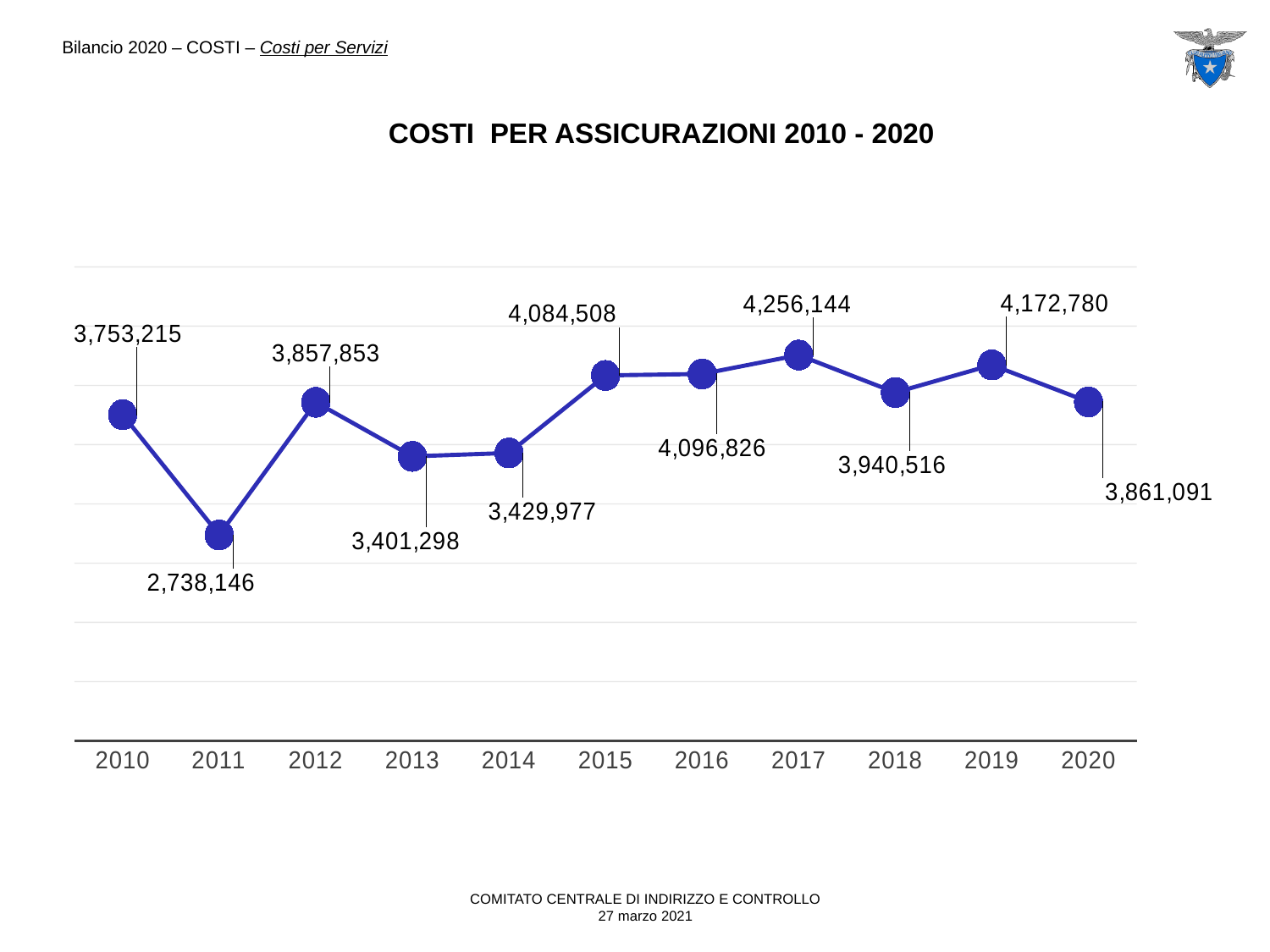
What kind of chart is shown on the slide? Line chart Which is larger, the value for 2013 or the value for 2018? 2018 Which year has the highest value in the chart? 2017 What is the value for 2011 in the chart? 2,738,146 What is the difference between the values for 2019 and 2020? 311,689 How many years are plotted in the chart? 11 What is the value for 2017 in the chart? 4,256,144 What is the difference between the values for 2017 and 2011? 1,517,998 Which year has the lowest value in the chart? 2011 What is the value for 2014 in the chart? 3,429,977 What is the title of the chart? COSTI PER ASSICURAZIONI 2010 - 2020 What is the value for 2020 in the chart? 3,861,091